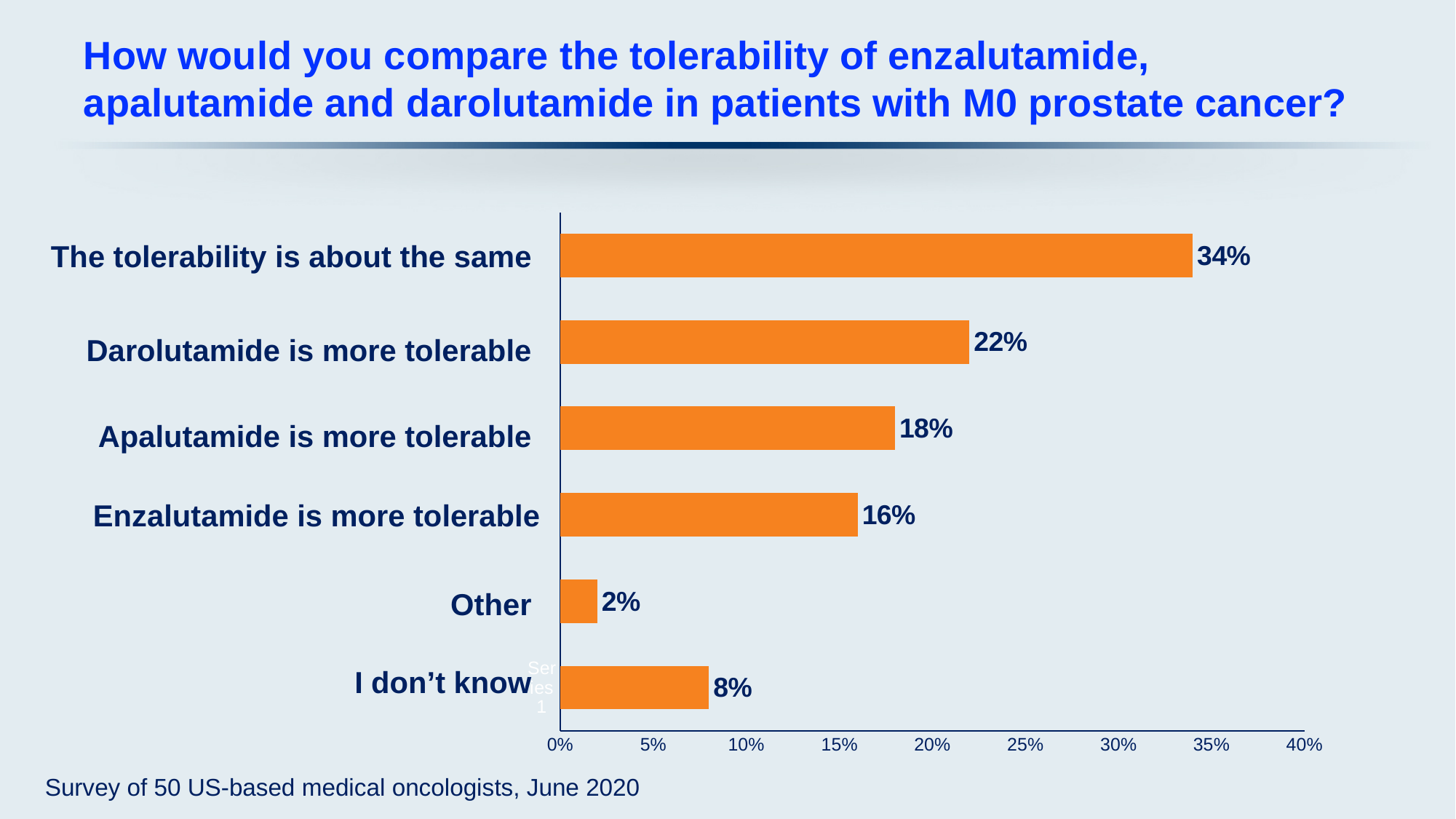
What percentage of respondents said the tolerability is about the same? 34% What is the maximum value shown on the horizontal axis? 40% What is the difference in percentage points between 'Darolutamide is more tolerable' and 'Apalutamide is more tolerable'? 4 percentage points What percentage of respondents answered 'I don't know'? 8% How many response categories are shown in the chart? 6 What percentage of respondents said enzalutamide is more tolerable? 16% What percentage of respondents said darolutamide is more tolerable? 22% What type of chart is shown on the slide? Bar chart Is the value for 'The tolerability is about the same' greater or less than 30%? greater Which response option has the lowest percentage? Other Which has a larger percentage: 'Apalutamide is more tolerable' or 'Enzalutamide is more tolerable'? Apalutamide is more tolerable Which response option has the highest percentage? The tolerability is about the same